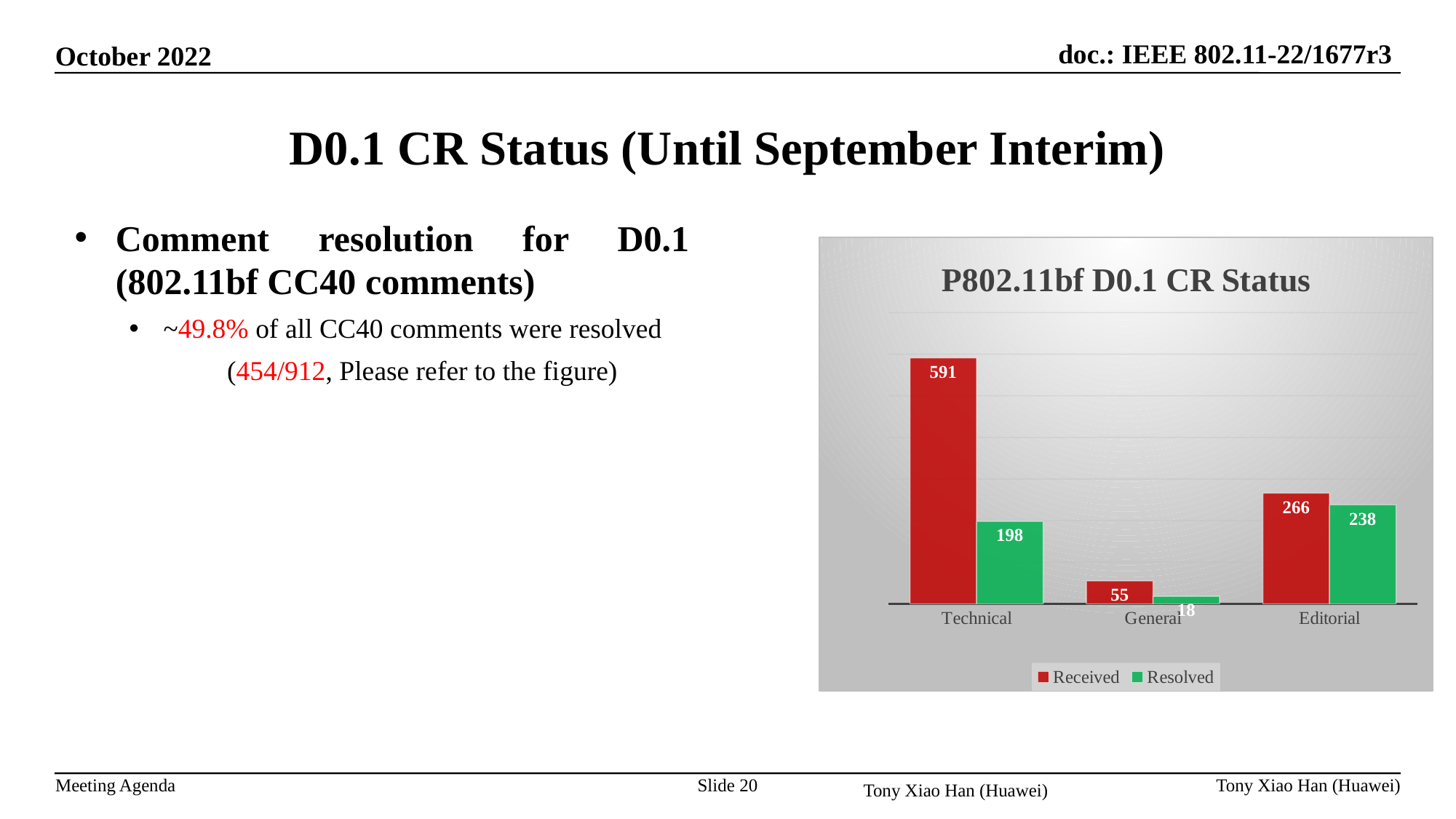
What is the difference between Received and Resolved for Editorial? 28 Which category has the lowest Resolved value? General How many categories are shown on the x axis? 3 What is the Received value for Editorial? 266 What is the Resolved value for Editorial? 238 What is the Resolved value for General? 18 How many series does the legend list? 2 What is the title of the chart? P802.11bf D0.1 CR Status What is the Received value for Technical? 591 What is the difference between Received and Resolved for Technical? 393 Which category has the highest Received value? Technical Which is larger, the Resolved value for Technical or the Resolved value for Editorial? Editorial